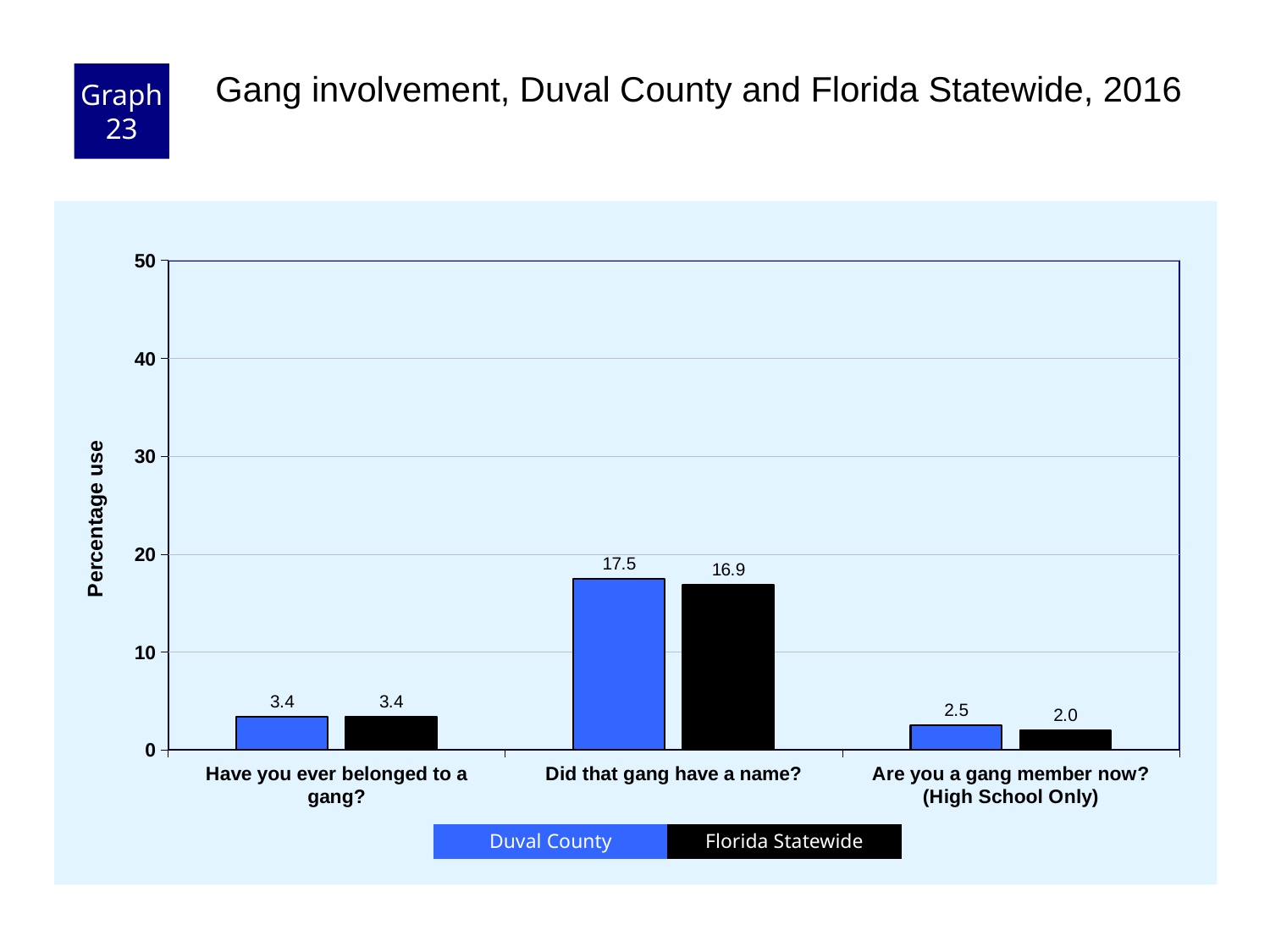
How many questions (categories) are shown on the x axis? 3 Is the Duval County value for "Did that gang have a name?" greater or less than 20? less What kind of chart is shown on the slide? bar chart What is the Florida Statewide value for "Did that gang have a name?"? 16.9 Which question has the highest Duval County value? Did that gang have a name? How many series does the legend list? 2 What is the Duval County value for "Are you a gang member now? (High School Only)"? 2.5 What is the Duval County value for "Did that gang have a name?"? 17.5 For "Are you a gang member now? (High School Only)", which is larger: Duval County or Florida Statewide? Duval County What is the Florida Statewide value for "Have you ever belonged to a gang?"? 3.4 Which question has the lowest Florida Statewide value? Are you a gang member now? (High School Only) What is the difference between the Duval County and Florida Statewide values for "Did that gang have a name?"? 0.6